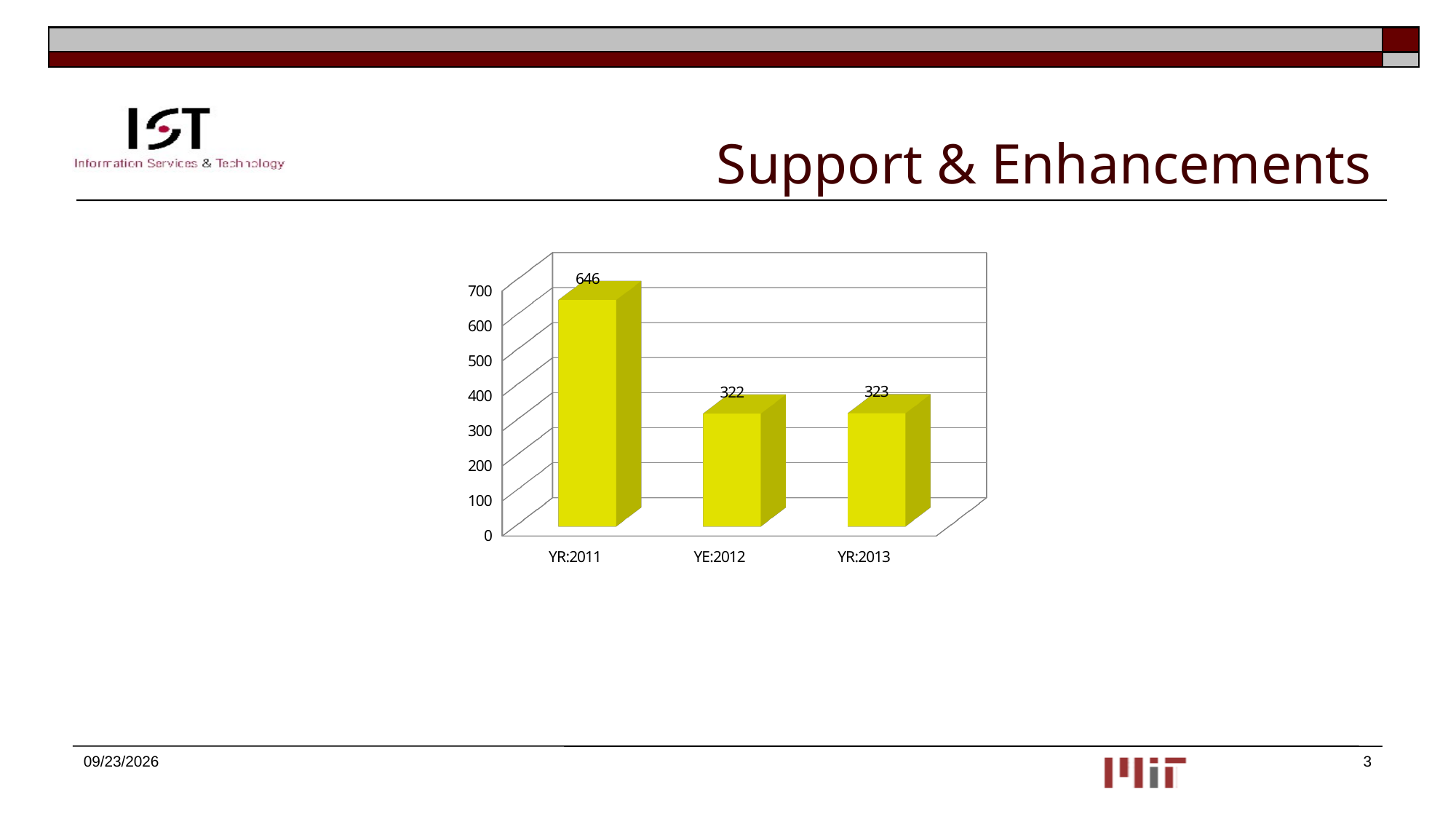
What is the value for YR:2011? 646 How many categories are shown on the x axis? 3 Which category has the highest value? YR:2011 What colour are the bars in the chart? yellow What is the difference between the values for YR:2011 and YE:2012? 324 What is the value for YE:2012? 322 Is the value for YR:2011 greater or less than 600? greater What is the difference between the values for YR:2011 and YR:2013? 323 Is the value for YE:2012 greater or less than 400? less What is the value for YR:2013? 323 Which is larger, the value for YR:2011 or the value for YR:2013? YR:2011 What kind of chart is shown on the slide? bar chart